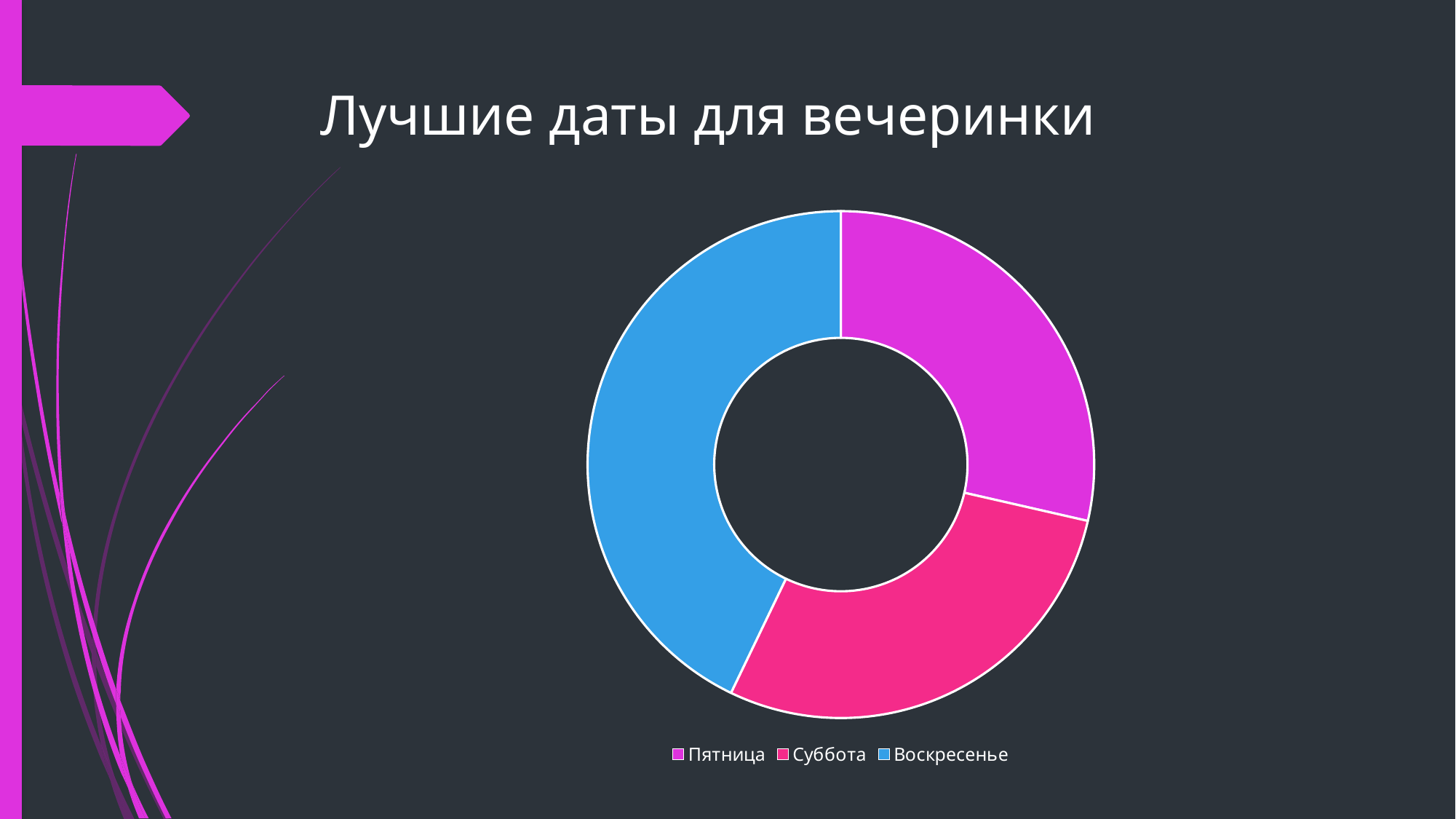
What is the title of the slide containing the chart? Лучшие даты для вечеринки What kind of chart is shown on the slide? Doughnut (pie) chart How many entries does the chart legend list? 3 How many categories (slices) does the chart have? 3 Which colour represents Воскресенье in the chart? Blue Which slice is larger, Воскресенье or Суббота? Воскресенье Which category has the largest slice in the chart? Воскресенье Which slice is larger, Воскресенье or Пятница? Воскресенье